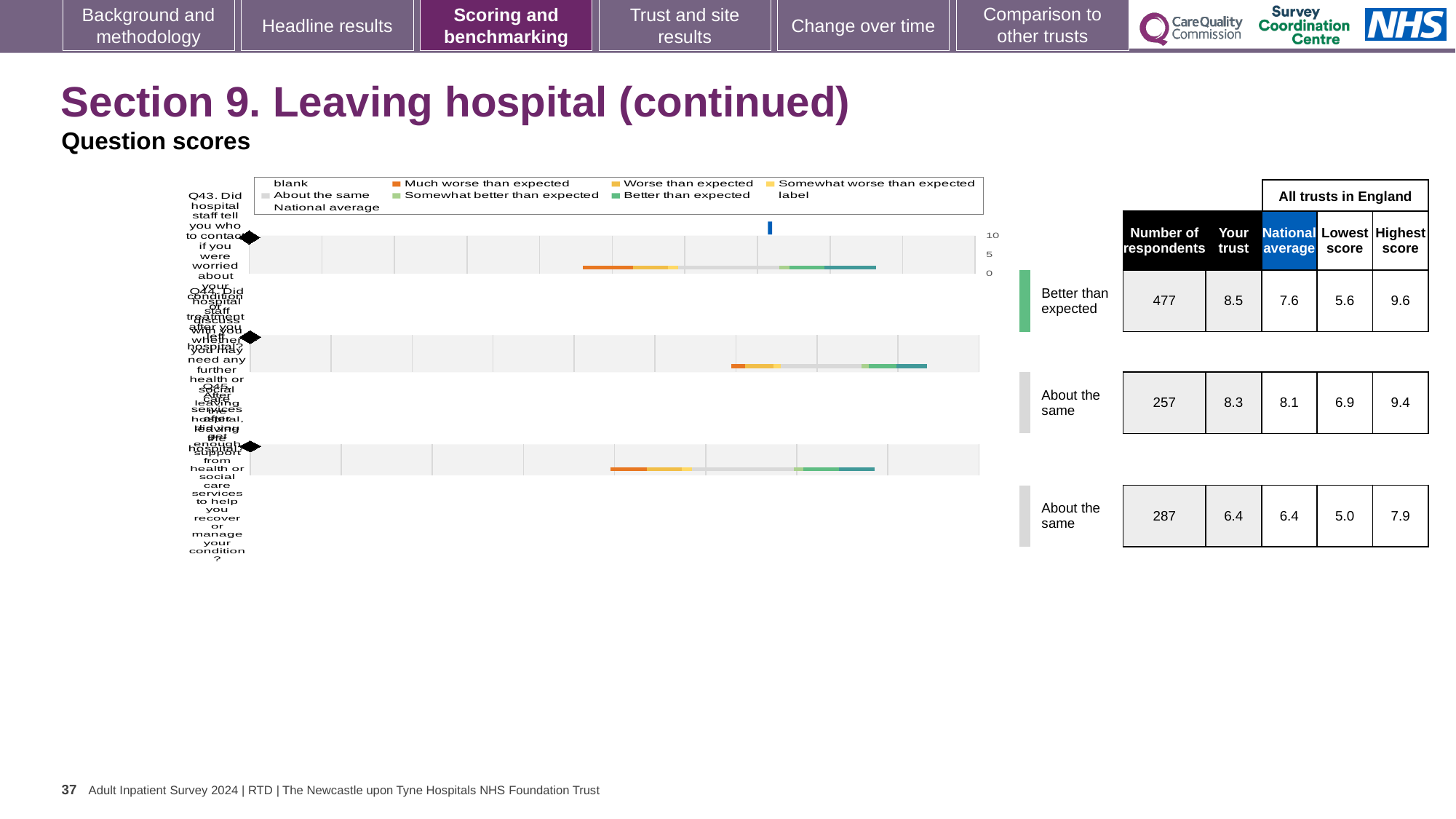
What is the maximum value shown on the chart's score axis? 10 What kind of chart is shown on the slide? bar chart In the table beside the chart, what is the number of respondents for the first row (Q43)? 477 Is the 'Your trust' score for the second row (Q44) larger or smaller than its national average? larger In the table beside the chart, what is the 'Your trust' score for the first row (Q43)? 8.5 In the table beside the chart, what is the highest score for the third row (Q45)? 7.9 What is the difference between the 'Your trust' score and the national average for the first row (Q43)? 0.9 What benchmark category is shown for the first row (Q43)? Better than expected In the table beside the chart, what is the national average for the second row (Q44)? 8.1 Which row has the lowest number of respondents in the table beside the chart? Q44 Which row has the highest 'Your trust' score in the table beside the chart? Q43 How many question rows (bars) are plotted in the chart? 3